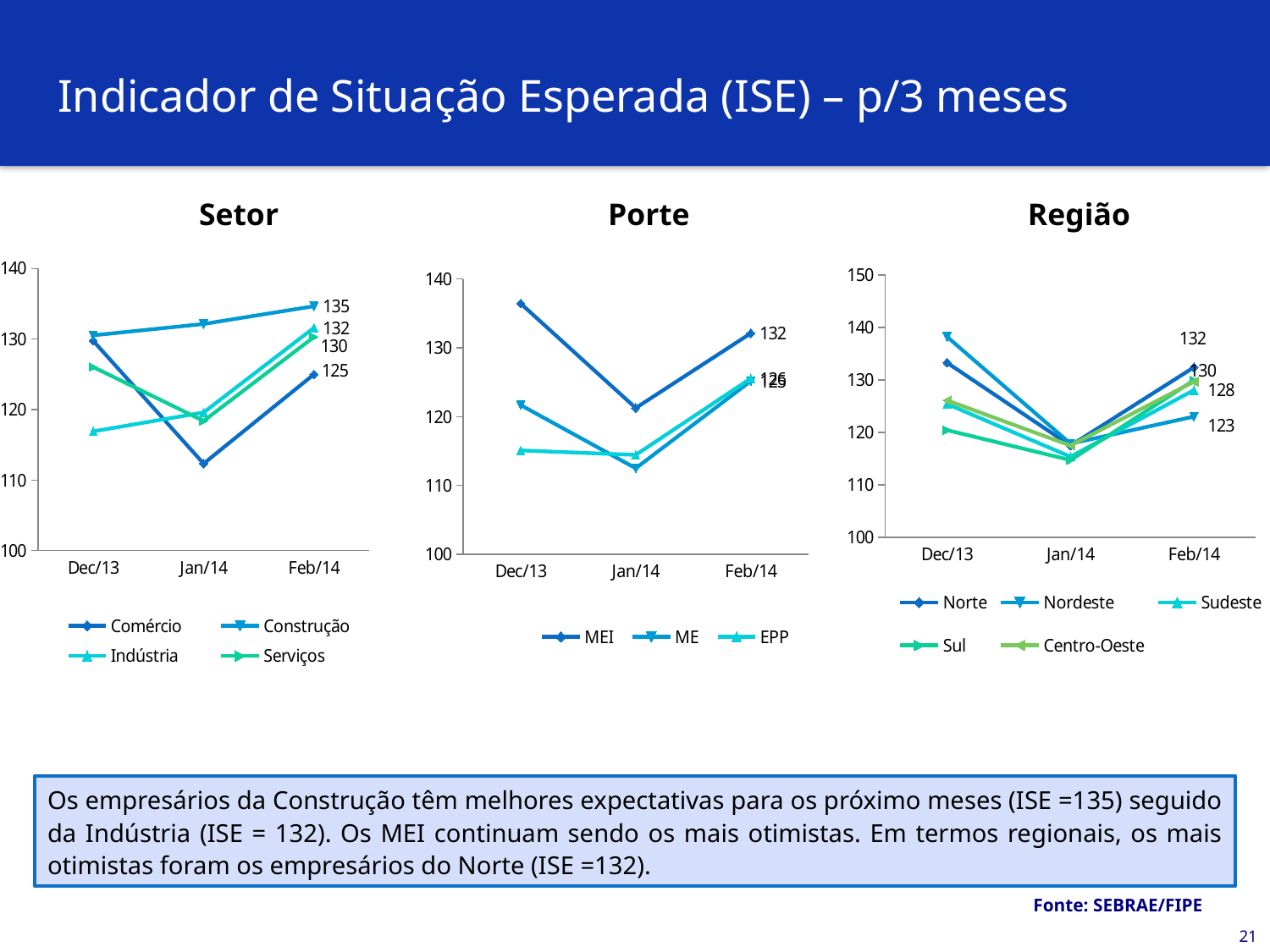
In the Setor chart, is the value for Comércio in Jan/14 greater or less than 120? less In the Porte chart, what is the value for MEI in Feb/14? 132 In the Região chart, how many series does the legend list? 5 In the Setor chart, how many series does the legend list? 4 In the Porte chart, is the value for MEI in Dec/13 greater or less than 130? greater In the Setor chart, which series has the highest value in Feb/14? Construção In the Porte chart, which series has the highest value in Feb/14? MEI In the Setor chart, what is the value for Construção in Feb/14? 135 In the Setor chart, what is the value for Indústria in Feb/14? 132 In the Setor chart, what is the value for Comércio in Feb/14? 125 In the Região chart, what is the value for Norte in Feb/14? 132 In the Setor chart, what is the difference between Construção and Comércio in Feb/14? 10